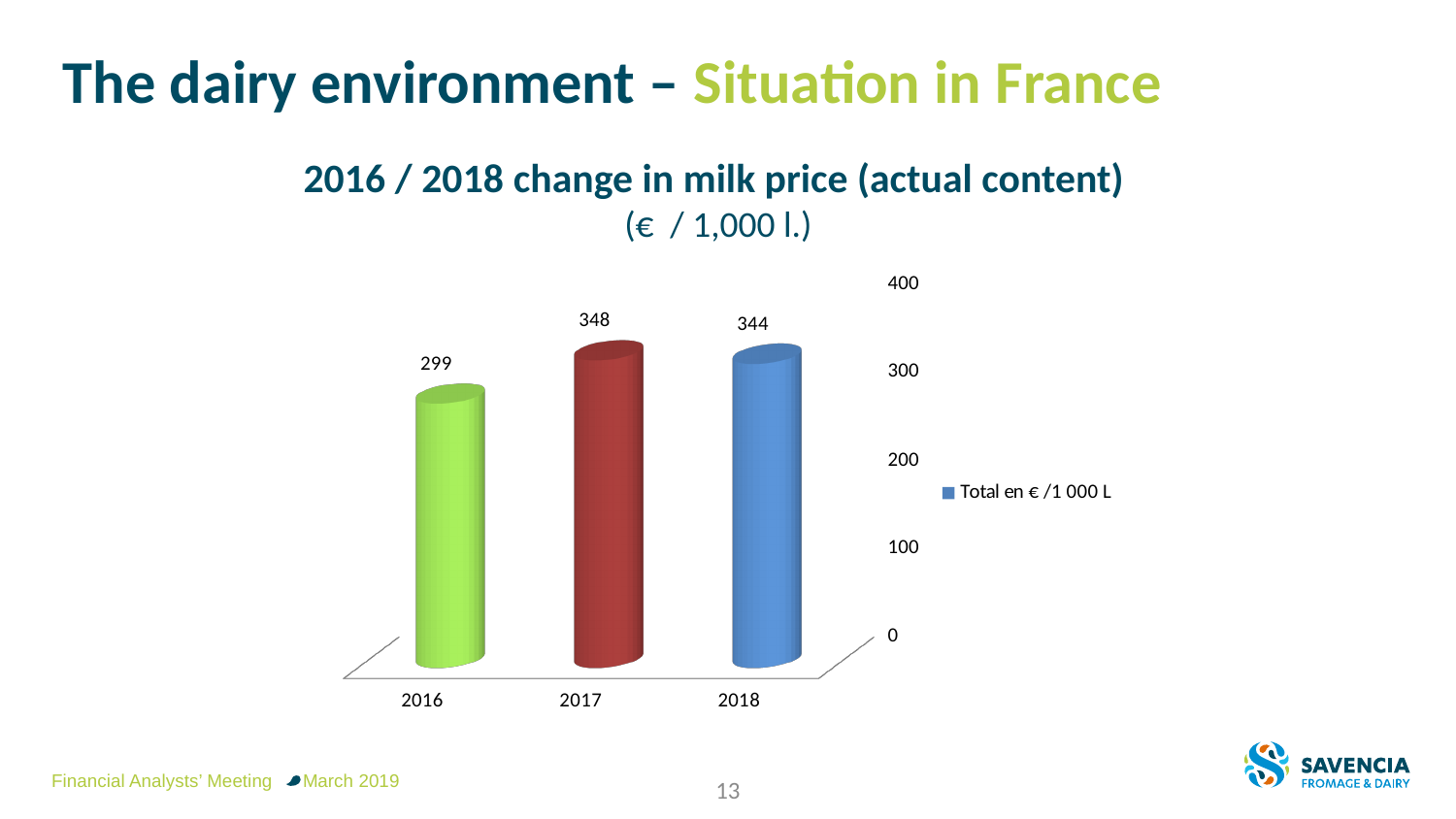
Is the value for 2016 greater or less than 300? less Which is larger, the value for 2016 or the value for 2018? 2018 Which year has the lowest milk price in the chart? 2016 What is the difference between the 2017 and 2016 milk price values? 49 What is the milk price value shown for 2017? 348 What is the milk price value shown for 2018? 344 What is the legend entry shown for the chart? Total en € /1 000 L What kind of chart is shown on the slide? bar chart Which year has the highest milk price in the chart? 2017 How many years are shown on the x axis of the chart? 3 What is the difference between the 2017 and 2018 milk price values? 4 What is the milk price value shown for 2016? 299